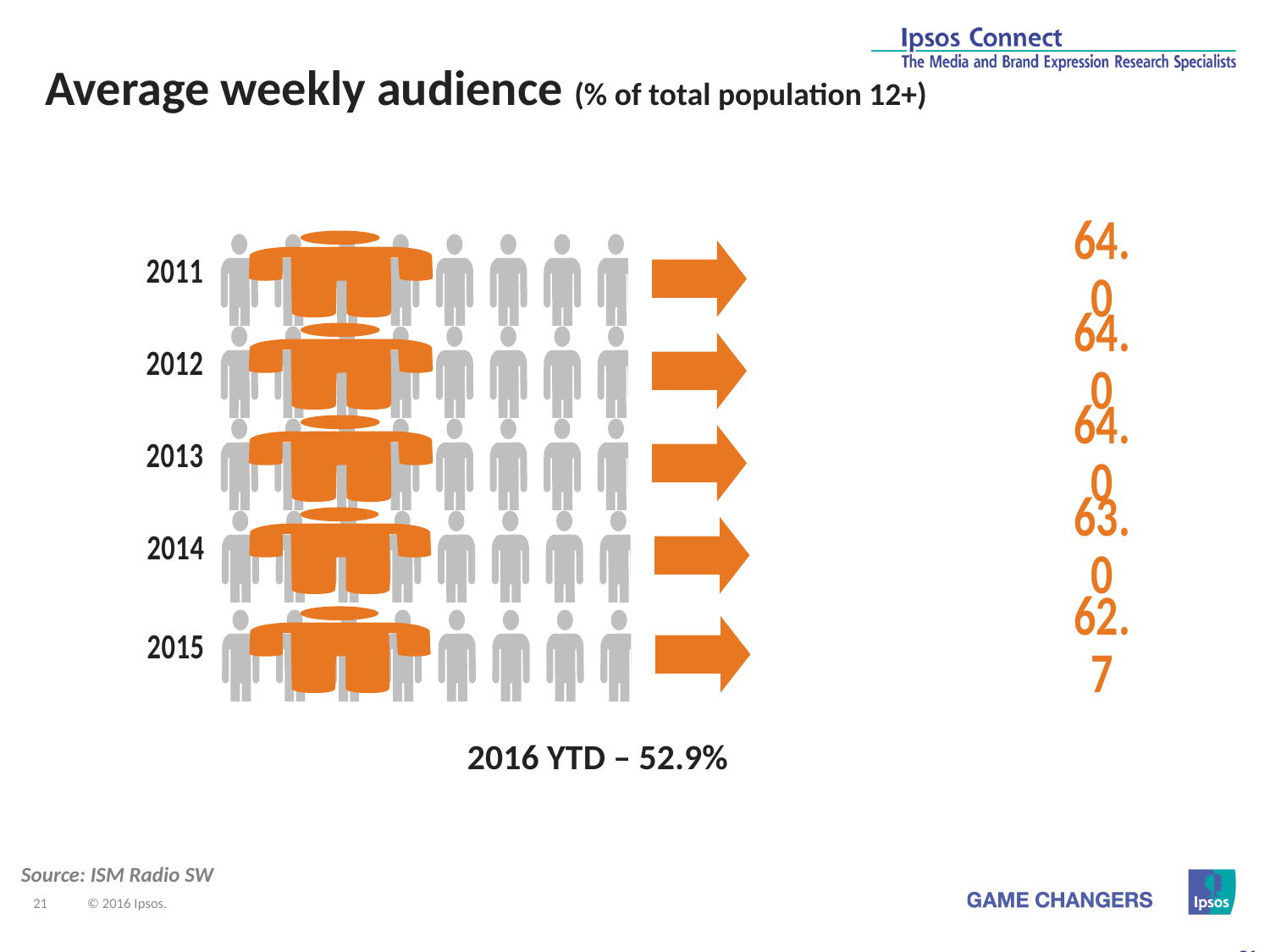
What is the difference between the 2011 value and the 2015 value? 1.3 What value is given for 2016 YTD? 52.9% What is the source cited for the chart? ISM Radio SW Do the values rise or fall from 2011 to 2015? fall Which of the years 2011 to 2015 has the lowest average weekly audience? 2015 What is the average weekly audience value shown for 2015? 62.7 What is the average weekly audience value shown for 2014? 63.0 What is the average weekly audience value shown for 2011? 64.0 What is the difference between the 2015 value and the 2016 YTD value? 9.8 Which is larger, the value for 2014 or the value for 2015? 2014 What is the title of the chart? Average weekly audience (% of total population 12+) How many years are shown as rows in the pictograph? 5